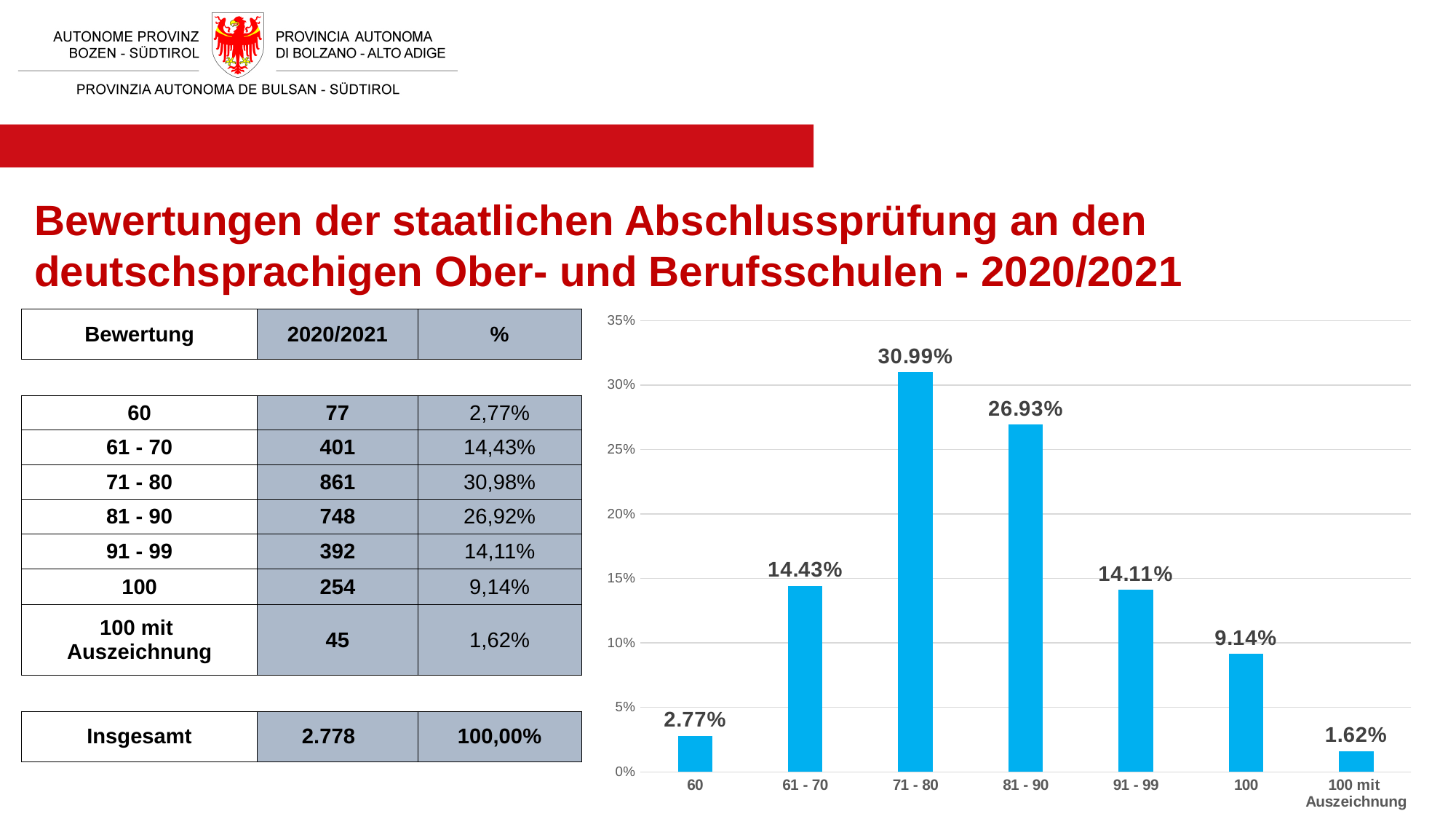
Is the value for "81 - 90" in the bar chart greater or less than 25%? greater Which is larger in the bar chart: the value for "61 - 70" or the value for "91 - 99"? 61 - 70 What is the value shown for the "61 - 70" category in the bar chart? 14.43% Which category has the highest value in the bar chart? 71 - 80 What is the value shown for the "71 - 80" category in the bar chart? 30.99% What is the value shown for the "100 mit Auszeichnung" category in the bar chart? 1.62% What is the highest value marked on the y axis of the bar chart? 35% What is the value shown for the "100" category in the bar chart? 9.14% What is the difference between the values for "71 - 80" and "81 - 90" in the bar chart? 4.06% How many categories are shown on the x axis of the bar chart? 7 Which category has the lowest value in the bar chart? 100 mit Auszeichnung What kind of chart is shown on the slide? bar chart